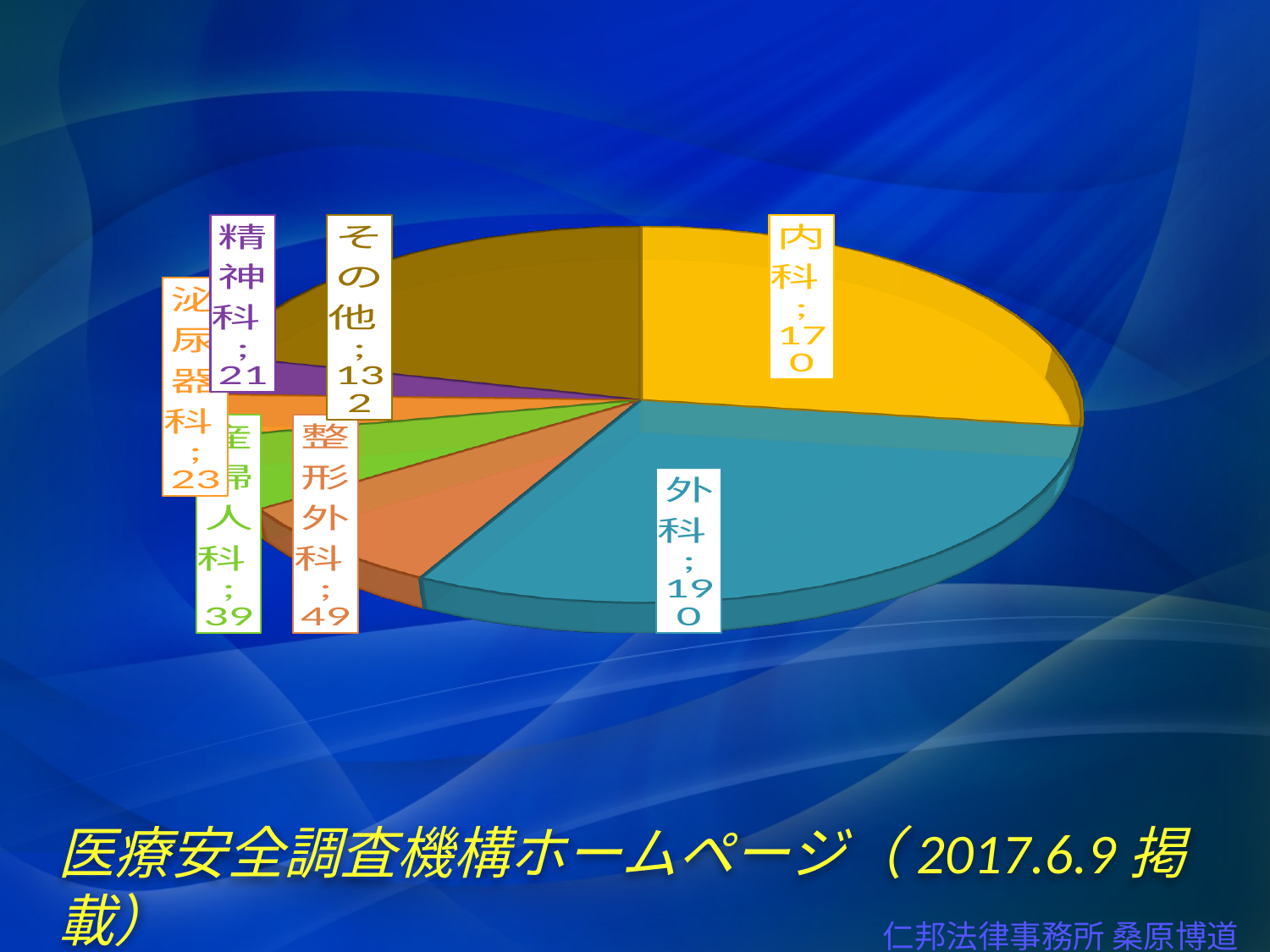
Which category has the smallest slice in the pie chart? 精神科 What is the difference between the values for 泌尿器科 and 精神科? 2 What is the value shown for その他 in the pie chart? 132 What is the value shown for 内科 in the pie chart? 170 What kind of chart is shown on the slide? Pie chart Which is larger, the value for 産婦人科 or the value for 整形外科? 整形外科 Which category has the largest slice in the pie chart? 外科 What is the value shown for 整形外科 in the pie chart? 49 What is the value shown for 泌尿器科 in the pie chart? 23 What is the value shown for 外科 in the pie chart? 190 How many categories are shown in the pie chart? 7 What is the difference between the values for 外科 and 内科? 20